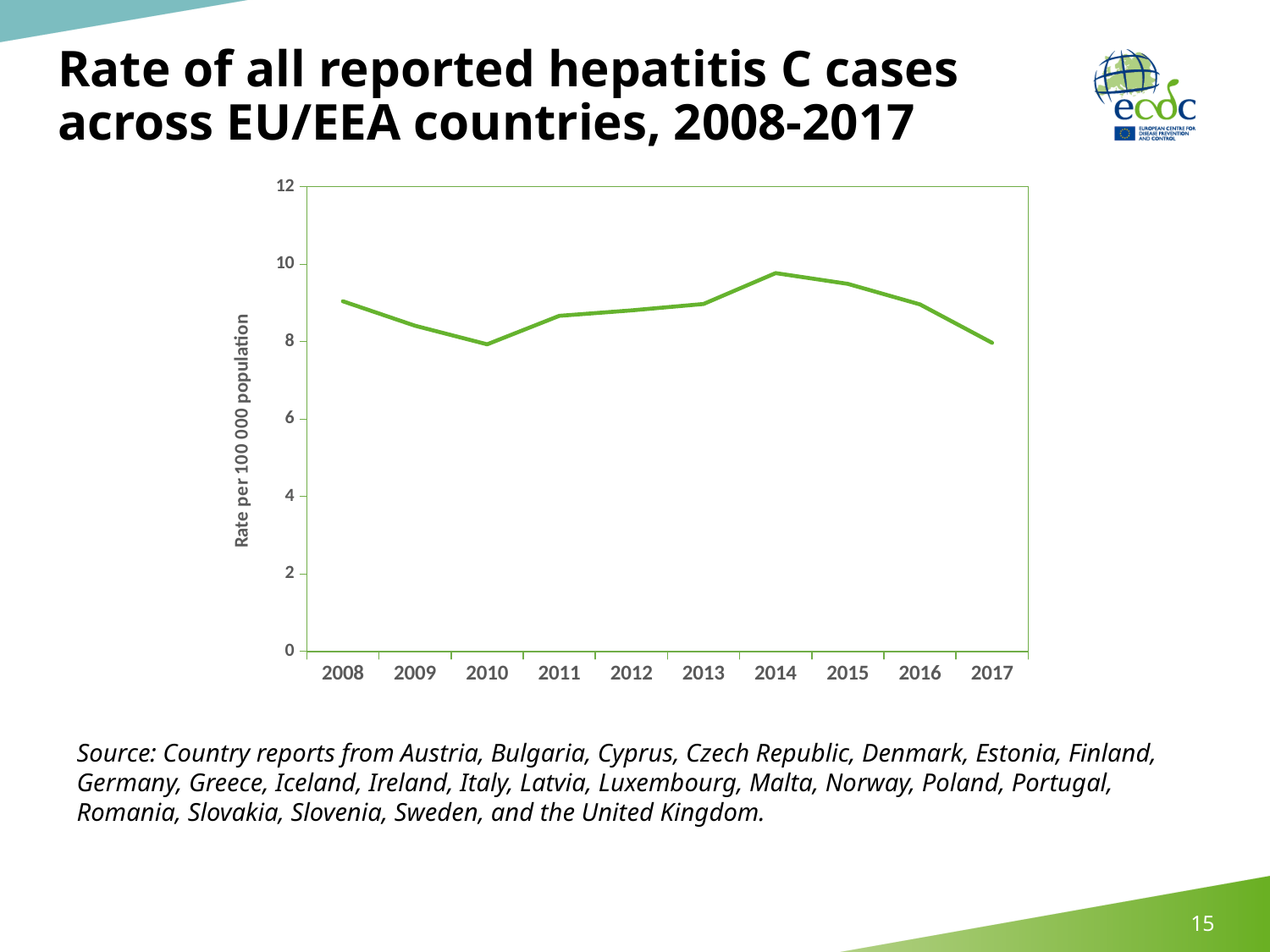
Is the value for 2017 greater or less than 10? less Is the value for 2014 greater or less than 8? greater Does the rate rise or fall from 2010 to 2014? rise Which year has the larger value, 2008 or 2010? 2008 Does the rate rise or fall from 2014 to 2017? fall What is the label on the y axis? Rate per 100 000 population In which year is the rate of reported hepatitis C cases highest? 2014 What kind of chart is shown on the slide? line chart Which year has the larger value, 2014 or 2010? 2014 Is the value for 2008 greater or less than 8? greater How many years are plotted on the x axis? 10